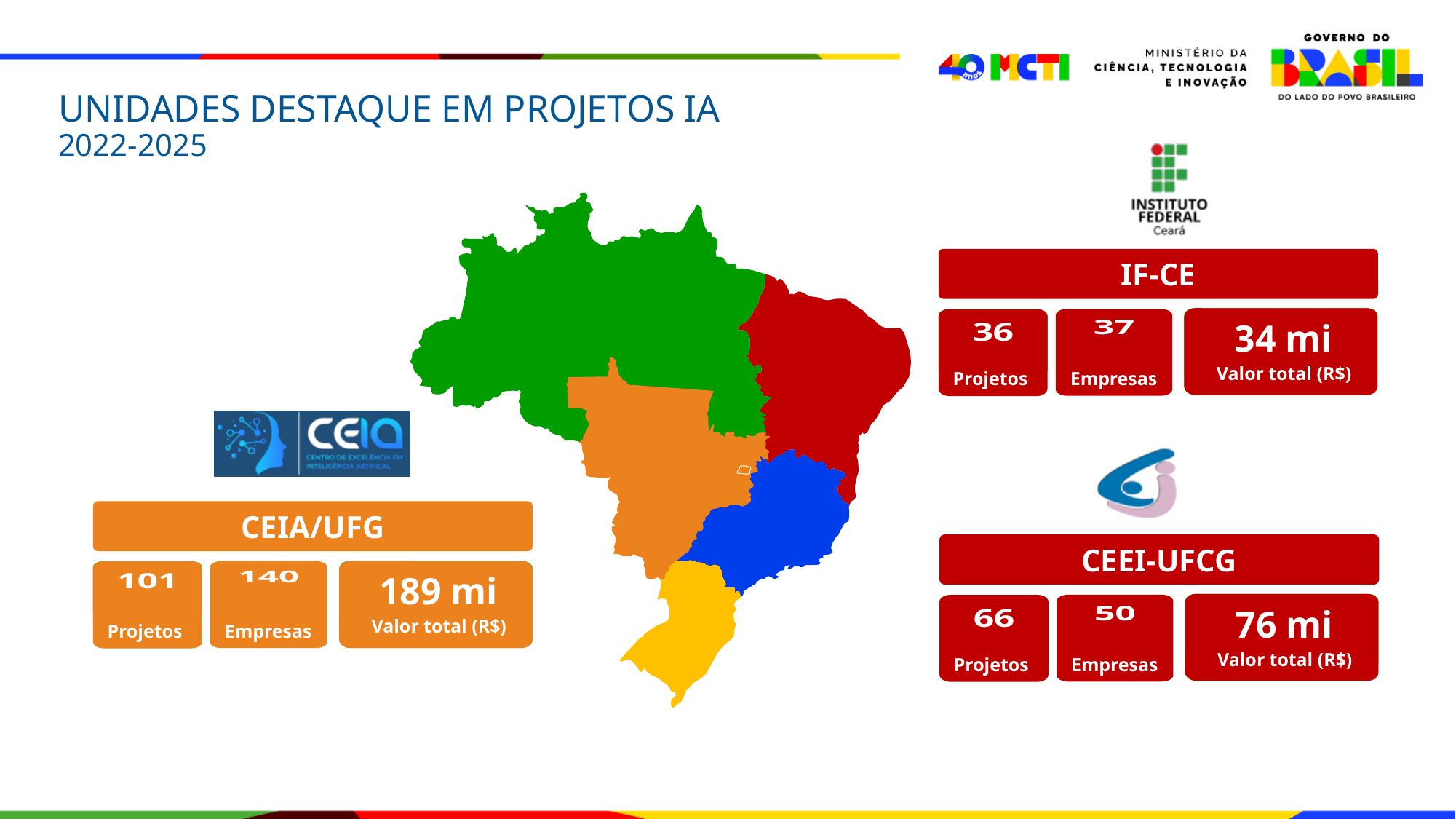
Which has more companies (Empresas), IF-CE or CEEI-UFCG? CEEI-UFCG How many projects (Projetos) are shown for CEIA/UFG? 101 What is the difference in the number of projects between CEIA/UFG and CEEI-UFCG? 35 What is the total value (Valor total) shown for CEEI-UFCG? 76 mi Which unit has the fewest projects (Projetos)? IF-CE How many companies (Empresas) are shown for IF-CE? 37 What period does the slide title refer to? 2022-2025 What is the difference in the number of companies (Empresas) between CEEI-UFCG and IF-CE? 13 Which unit has the highest total value (Valor total)? CEIA/UFG What kind of visual is used to show the location of the units? A map of Brazil How many units are highlighted on the slide? 3 How many projects (Projetos) are shown for CEEI-UFCG? 66